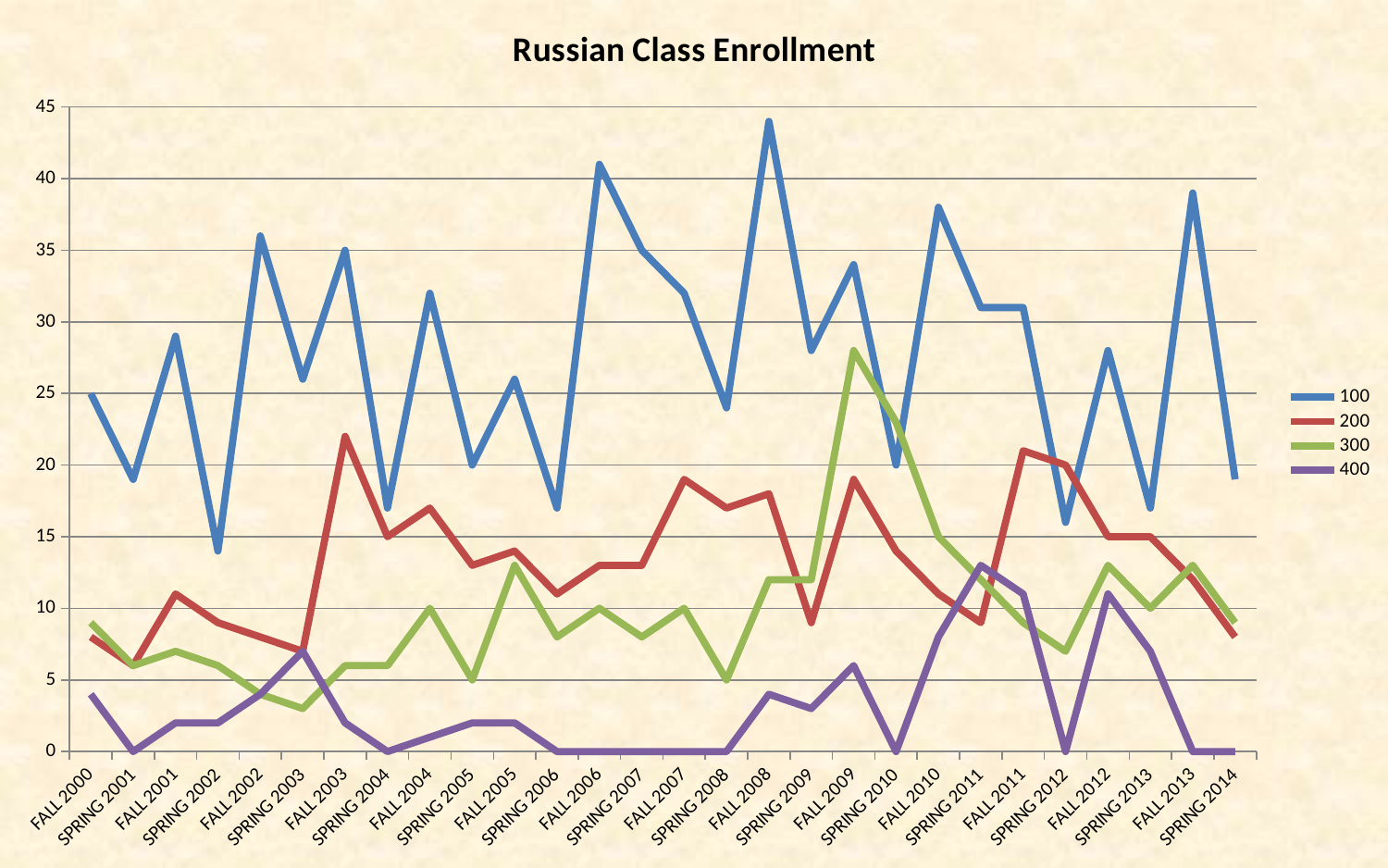
Is the value of the 100 series for FALL 2008 greater or less than 40? greater What type of chart is shown on the slide? Line chart What is the value of the 400 series for SPRING 2001? 0 What is the title of the chart? Russian Class Enrollment In which semester does the 300 series reach its highest value? FALL 2009 Is the value of the 300 series for FALL 2009 greater or less than 25? greater In which semester does the 100 series reach its highest value? FALL 2008 What is the value of the 300 series for FALL 2010? 15 What is the value of the 100 series for FALL 2000? 25 For FALL 2009, which series has the larger value, 200 or 300? 300 How many semesters (x-axis categories) are plotted on the chart? 28 How many series does the legend list? 4